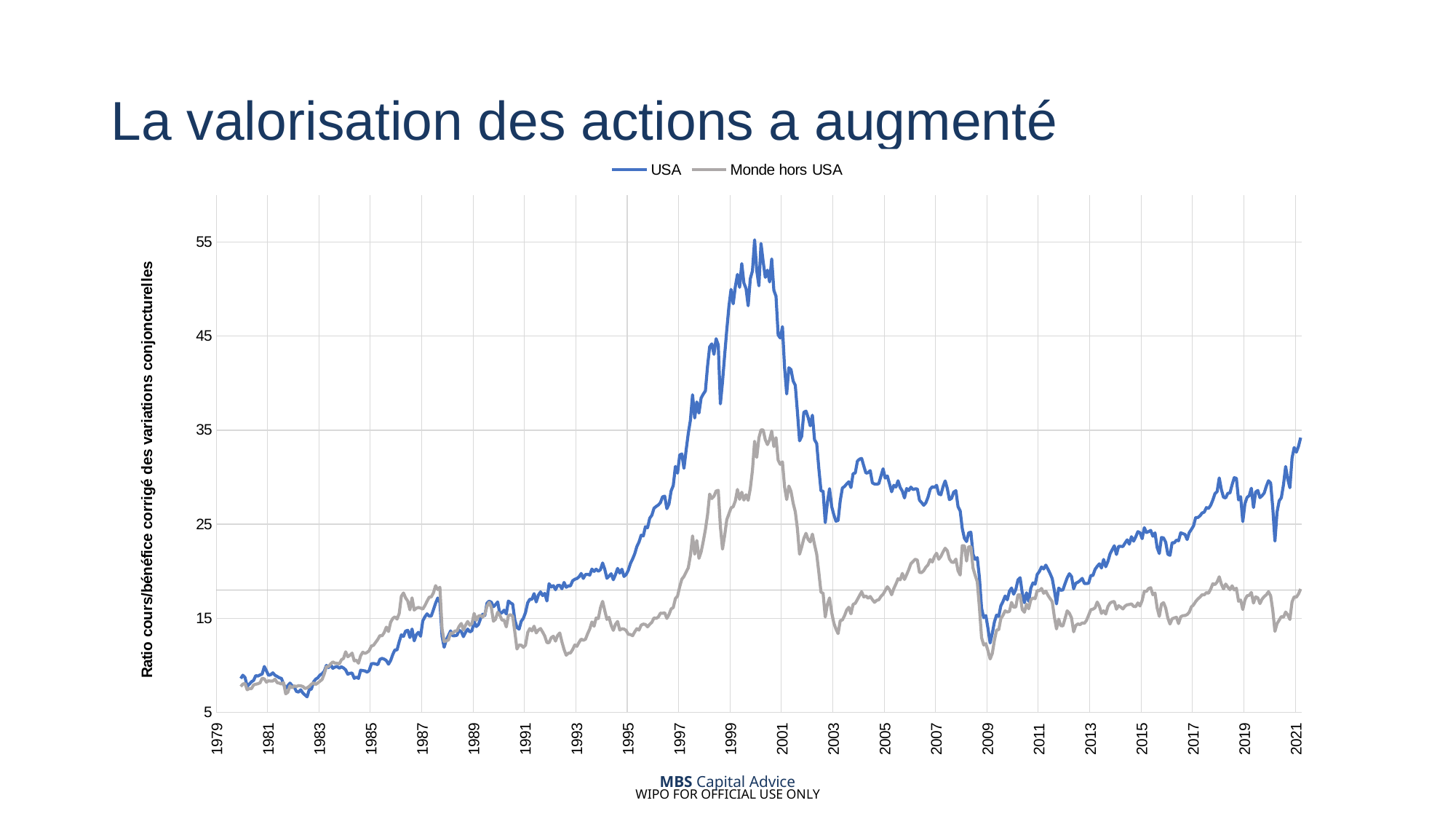
Does the USA series rise or fall between 1995 and 2000? rise Is the peak value of the Monde hors USA series around 2000 greater or less than 45? less Is the value of the Monde hors USA series in 2021 greater or less than 25? less Is the peak value of the USA series around 2000 greater or less than 45? greater What are the two series named in the legend? USA and Monde hors USA Around 2000, which series is higher, USA or Monde hors USA? USA At the end of the chart in 2021, which series is higher, USA or Monde hors USA? USA Does the USA series rise or fall between 2000 and 2003? fall How many series does the legend list? 2 What kind of chart is shown on the slide? line chart What is the title of the slide above the chart? La valorisation des actions a augmenté